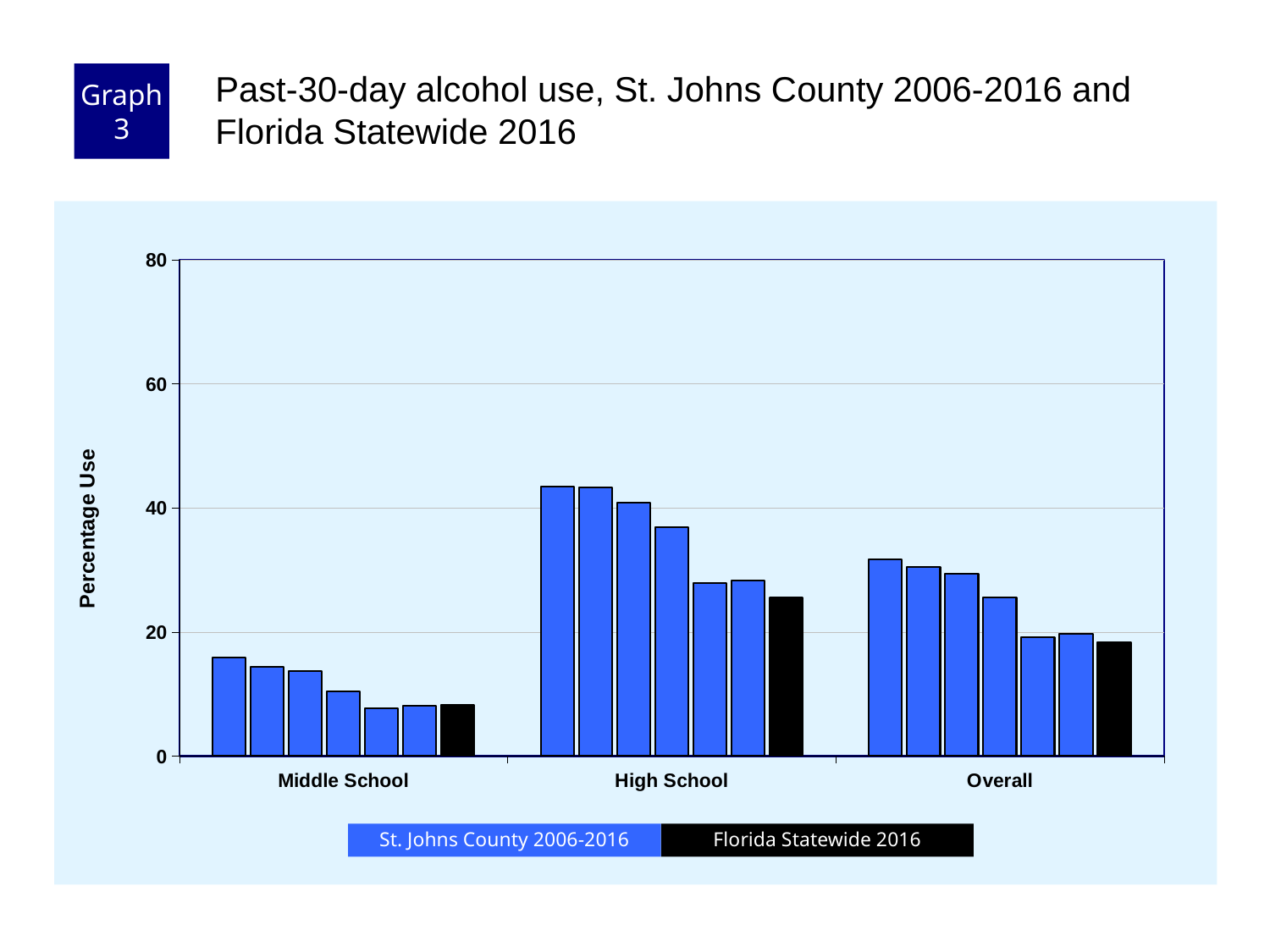
Is the tallest St. Johns County bar for Overall greater or less than 40? less Which category has the highest bars overall? High School What kind of chart is shown on the slide? Bar chart Within the High School group, do the St. Johns County 2006-2016 bars generally rise or fall from left to right? Fall Is the Florida Statewide 2016 value for Middle School greater or less than 20? less Which category has the lowest bars overall? Middle School What is the label on the y axis? Percentage Use Which is larger, the Florida Statewide 2016 value for High School or for Middle School? High School Is the tallest St. Johns County bar for High School greater or less than 40? greater How many categories are shown along the x axis? 3 How many series does the legend list? 2